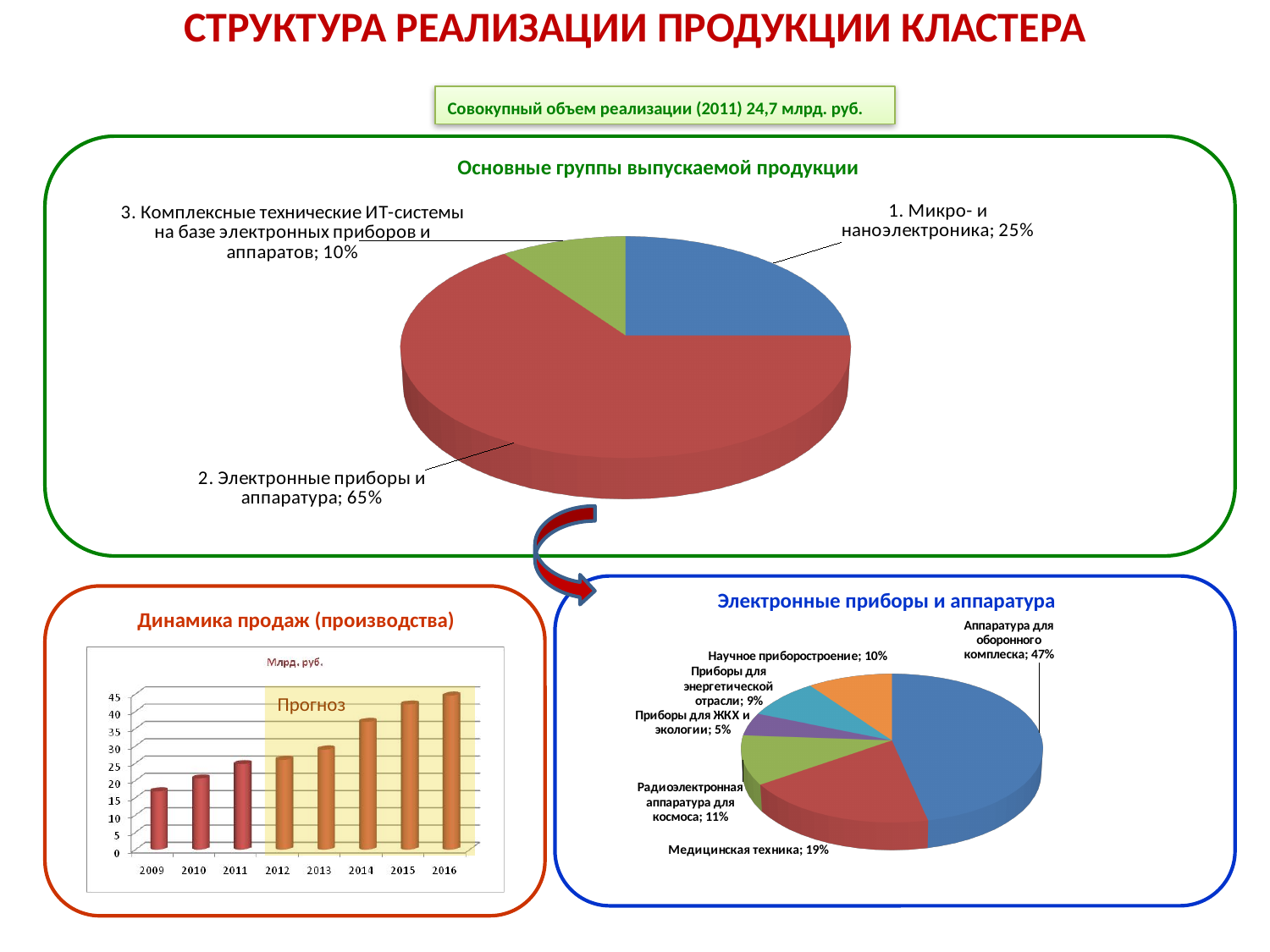
In the pie chart 'Основные группы выпускаемой продукции', how many slices are there? 3 In the pie chart 'Электронные приборы и аппаратура', what share is 'Медицинская техника'? 19% In the chart 'Динамика продаж (производства)', do the values rise or fall from 2009 to 2016? Rise In the pie chart 'Электронные приборы и аппаратура', how many categories are shown? 6 What kind of chart is 'Динамика продаж (производства)'? Bar chart In the chart 'Динамика продаж (производства)', is the value for 2015 greater or less than 40? greater In the pie chart 'Основные группы выпускаемой продукции', what share is '2. Электронные приборы и аппаратура'? 65% In the pie chart 'Основные группы выпускаемой продукции', which group has the smallest share? 3. Комплексные технические ИТ-системы на базе электронных приборов и аппаратов In the pie chart 'Электронные приборы и аппаратура', which is larger: 'Научное приборостроение' or 'Приборы для энергетической отрасли'? Научное приборостроение In the pie chart 'Электронные приборы и аппаратура', which category has the largest share? Аппаратура для оборонного комплеска In the pie chart 'Основные группы выпускаемой продукции', what is the difference between the shares of '1. Микро- и наноэлектроника' and '3. Комплексные технические ИТ-системы'? 15% In the chart 'Динамика продаж (производства)', is the value for 2009 greater or less than 20? less